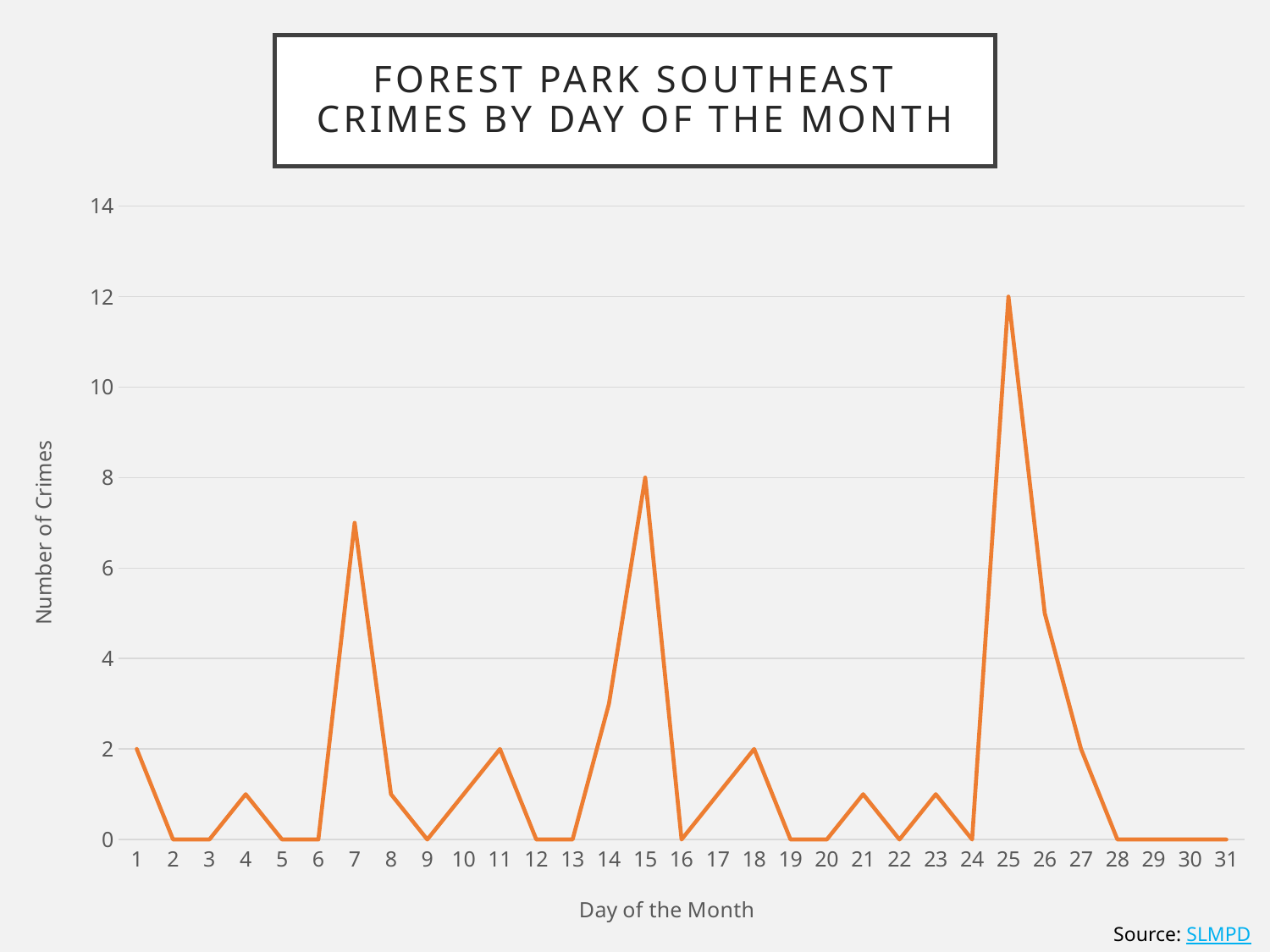
How many crimes were recorded on day 1? 2 Is the value for day 7 greater or less than 6? greater What is the label of the vertical axis? Number of Crimes What kind of chart is shown on the slide? line chart How many crimes were recorded on day 25? 12 Which day has more crimes, day 15 or day 7? 15 How many crimes were recorded on day 30? 0 How many days are plotted along the x axis? 31 Which day of the month has the highest number of crimes? 25 Is the value for day 26 greater or less than 4? greater What is the difference between the number of crimes on day 25 and on day 15? 4 How many crimes were recorded on day 15? 8